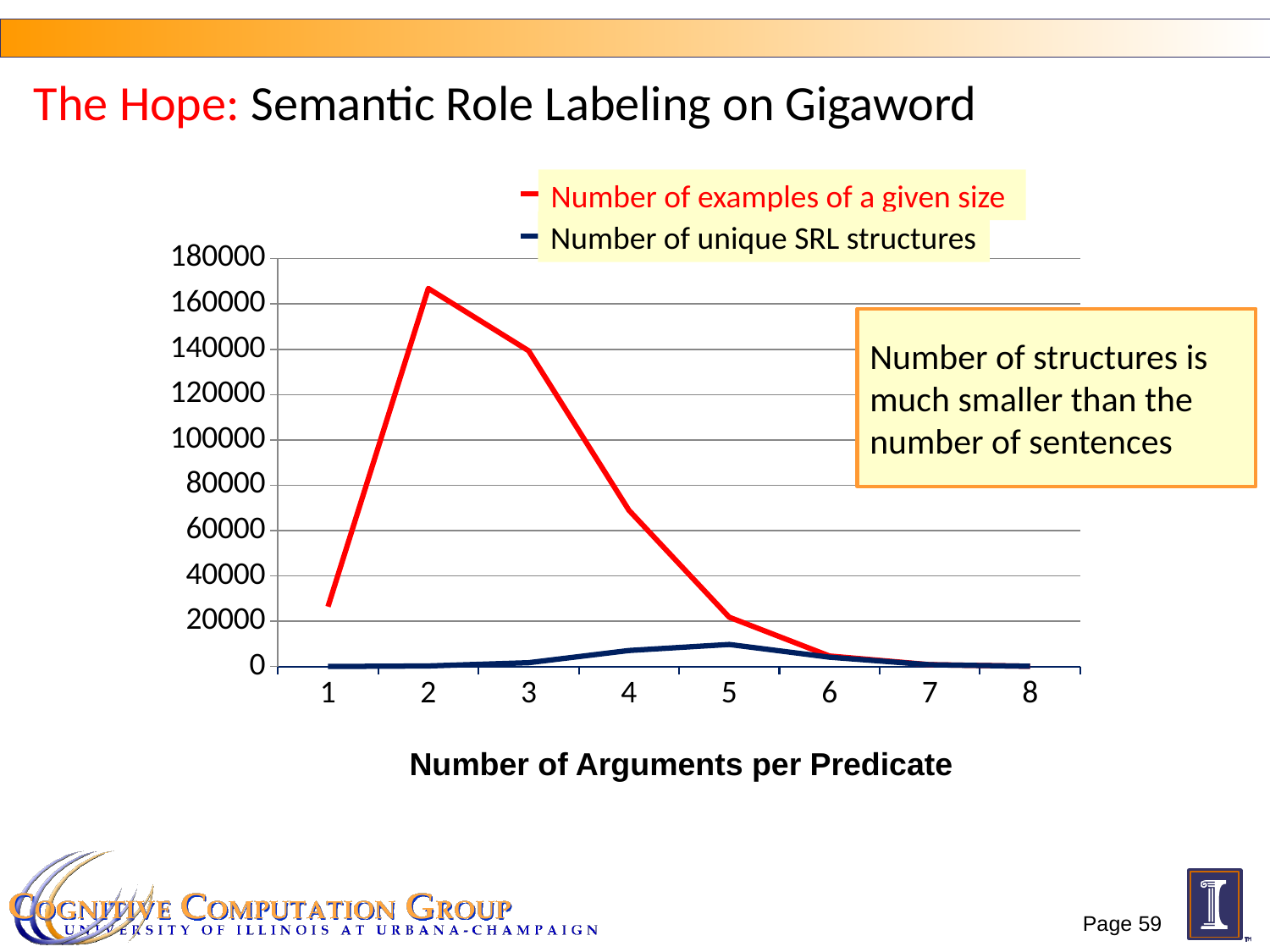
What kind of chart is shown on the slide? line chart How many series does the legend list? 2 Is the value of 'Number of examples of a given size' at 4 arguments greater or less than 80000? less From 2 to 8 arguments per predicate, does the 'Number of examples of a given size' line rise or fall? fall What is the title of the x axis? Number of Arguments per Predicate Is the value of 'Number of examples of a given size' at 3 arguments greater or less than 160000? less Is the value of 'Number of examples of a given size' at 1 argument greater or less than 20000? greater How many points along the x axis does each line have? 8 At 3 arguments per predicate, which series has the larger value: 'Number of examples of a given size' or 'Number of unique SRL structures'? Number of examples of a given size At which number of arguments per predicate does the 'Number of unique SRL structures' line reach its highest value? 5 At which number of arguments per predicate does the 'Number of examples of a given size' line reach its highest value? 2